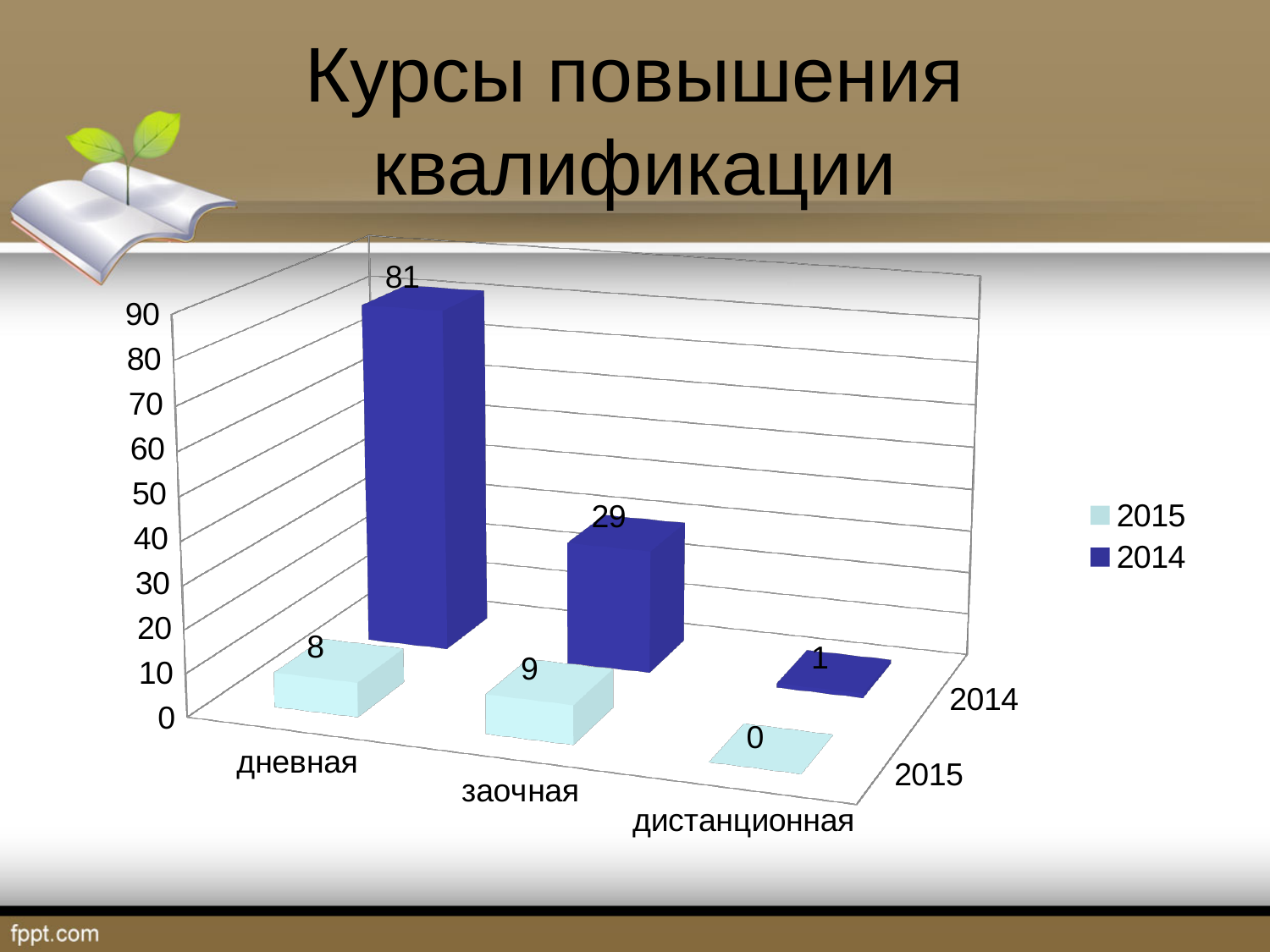
Which category has the highest value in 2014? дневная What is the difference between the 2014 and 2015 values for дневная? 73 What kind of chart is shown on the slide? bar chart How many series does the legend list? 2 What is the difference between the 2014 and 2015 values for заочная? 20 What is the value for дневная in 2015? 8 What is the value for дистанционная in 2014? 1 What is the value for заочная in 2015? 9 Which category has the lowest value in 2015? дистанционная How many categories are shown on the x axis? 3 What is the value for дневная in 2014? 81 Which is larger: the 2015 value for дневная or the 2015 value for заочная? заочная